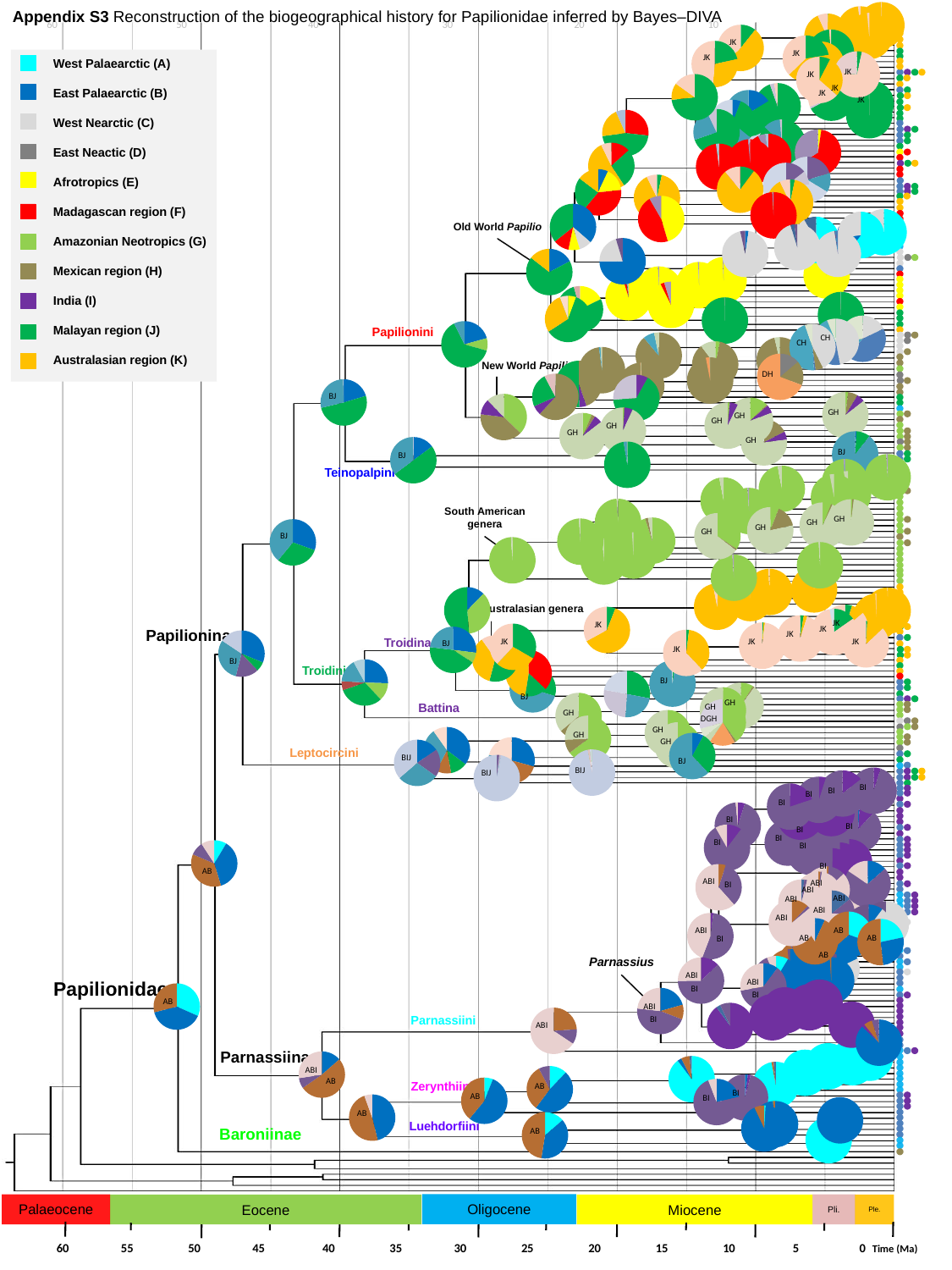
How many biogeographical regions does the legend list? 11 Which region does the yellow colour in the legend represent? Afrotropics (E) What ancestral-area label is printed on the pie at the Papilionidae root node? AB What ancestral-area label is printed on the pie at the Leptocircini node? BIJ What letter code is assigned to the Malayan region in the legend? J How many geological periods are labelled on the time bar at the bottom of the tree? 6